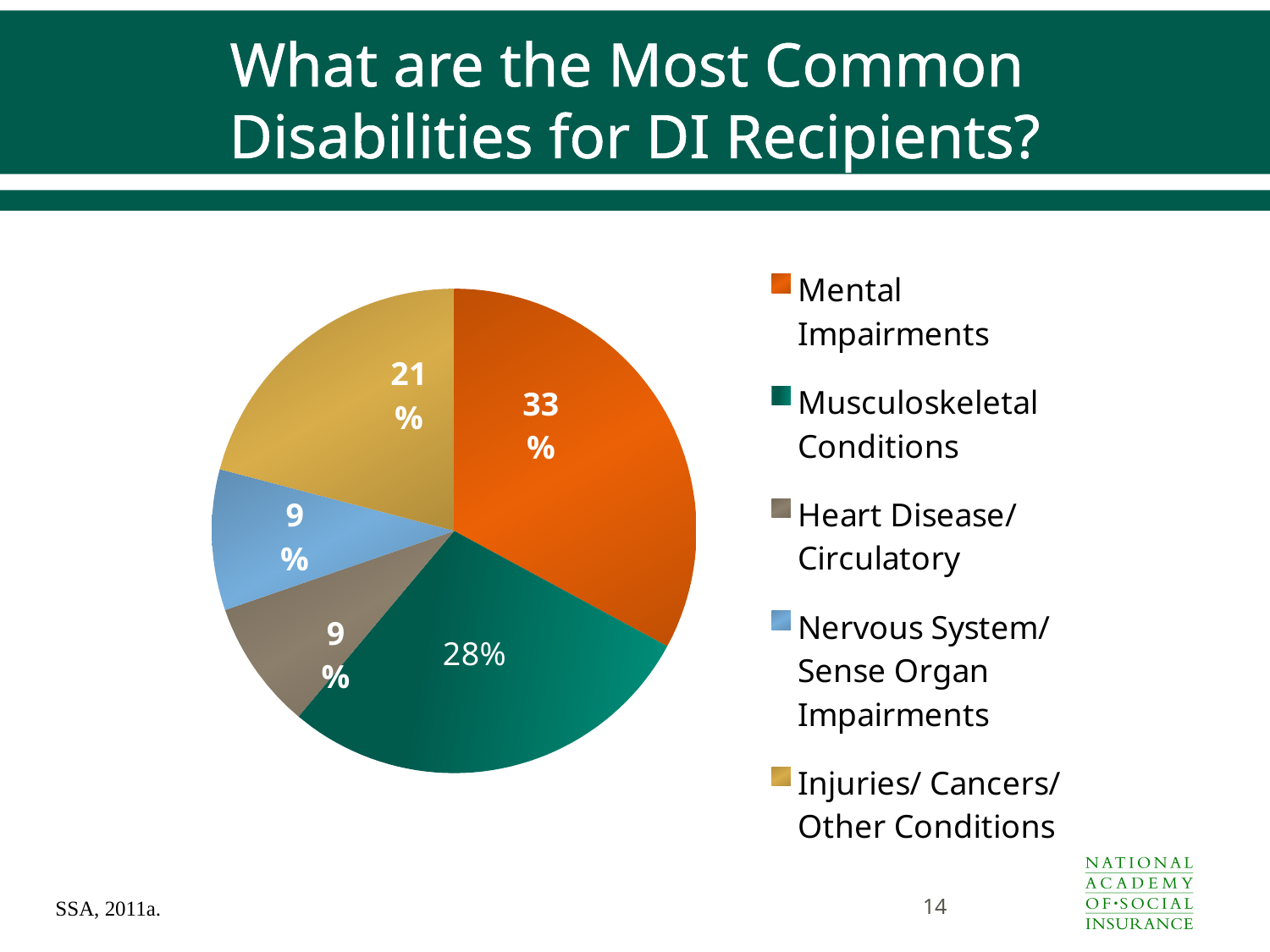
Which category has the largest slice of the pie? Mental Impairments What is the title of the slide containing the chart? What are the Most Common Disabilities for DI Recipients? How many categories does the legend list? 5 What is the difference in percentage points between Mental Impairments and Musculoskeletal Conditions? 5 What share of DI recipients have Mental Impairments? 33% What share of DI recipients have Musculoskeletal Conditions? 28% What colour is the slice for Musculoskeletal Conditions? green What share of DI recipients have Heart Disease/ Circulatory conditions? 9% What is the difference in percentage points between Injuries/ Cancers/ Other Conditions and Nervous System/ Sense Organ Impairments? 12 What share of DI recipients have Injuries/ Cancers/ Other Conditions? 21% Which is larger: the share for Musculoskeletal Conditions or the share for Injuries/ Cancers/ Other Conditions? Musculoskeletal Conditions What kind of chart is shown on the slide? pie chart